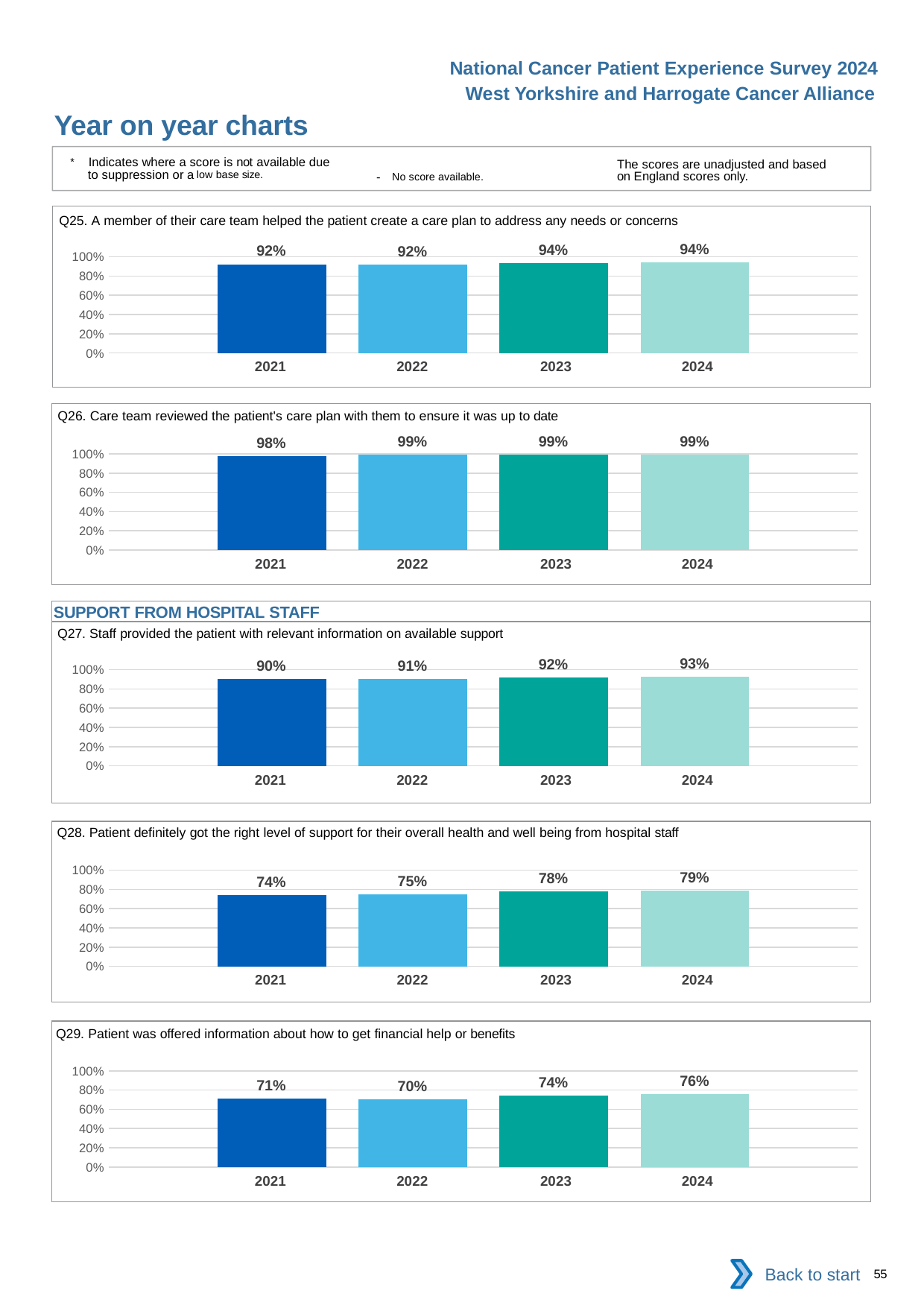
In the Q28 chart, which is larger, the value for 2022 or the value for 2023? 2023 In the Q29 chart, what is the difference between the 2024 value and the 2022 value? 6% What is the section heading shown above the Q27 chart? SUPPORT FROM HOSPITAL STAFF In the Q26 chart, what is the value for 2021? 98% In the Q28 chart, do the values rise or fall from 2021 to 2024? rise In the Q25 chart, what is the value for 2023? 94% What kind of chart is the Q25 chart? bar chart How many years are shown in the Q27 chart? 4 In the Q29 chart, is the value for 2021 greater or less than 80%? less In the Q27 chart, which year has the highest value? 2024 In the Q28 chart, which year has the lowest value? 2021 In the Q29 chart, what is the value for 2023? 74%